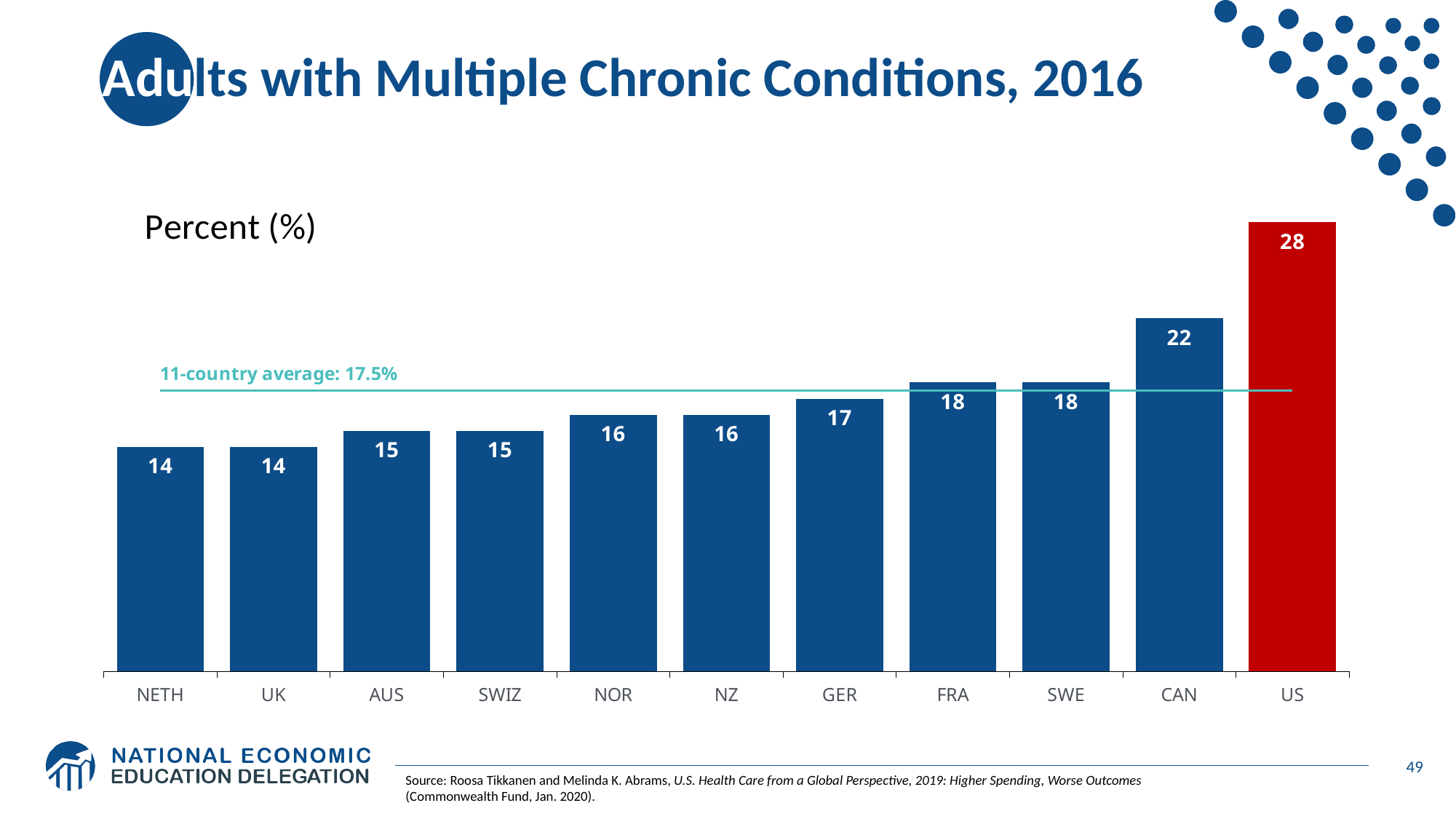
How many countries are shown on the chart? 11 What is the value for CAN? 22 What is the difference between the values for FRA and NETH? 4 Do the values rise or fall from left to right along the x axis? rise What is the 11-country average shown on the chart? 17.5% What is the value for the US? 28 What is the value for GER? 17 Which country has the highest value? US Which country's bar is coloured red? US What kind of chart is shown on the slide? bar chart What is the difference between the values for the US and CAN? 6 Which is larger, the value for NOR or the value for SWE? SWE